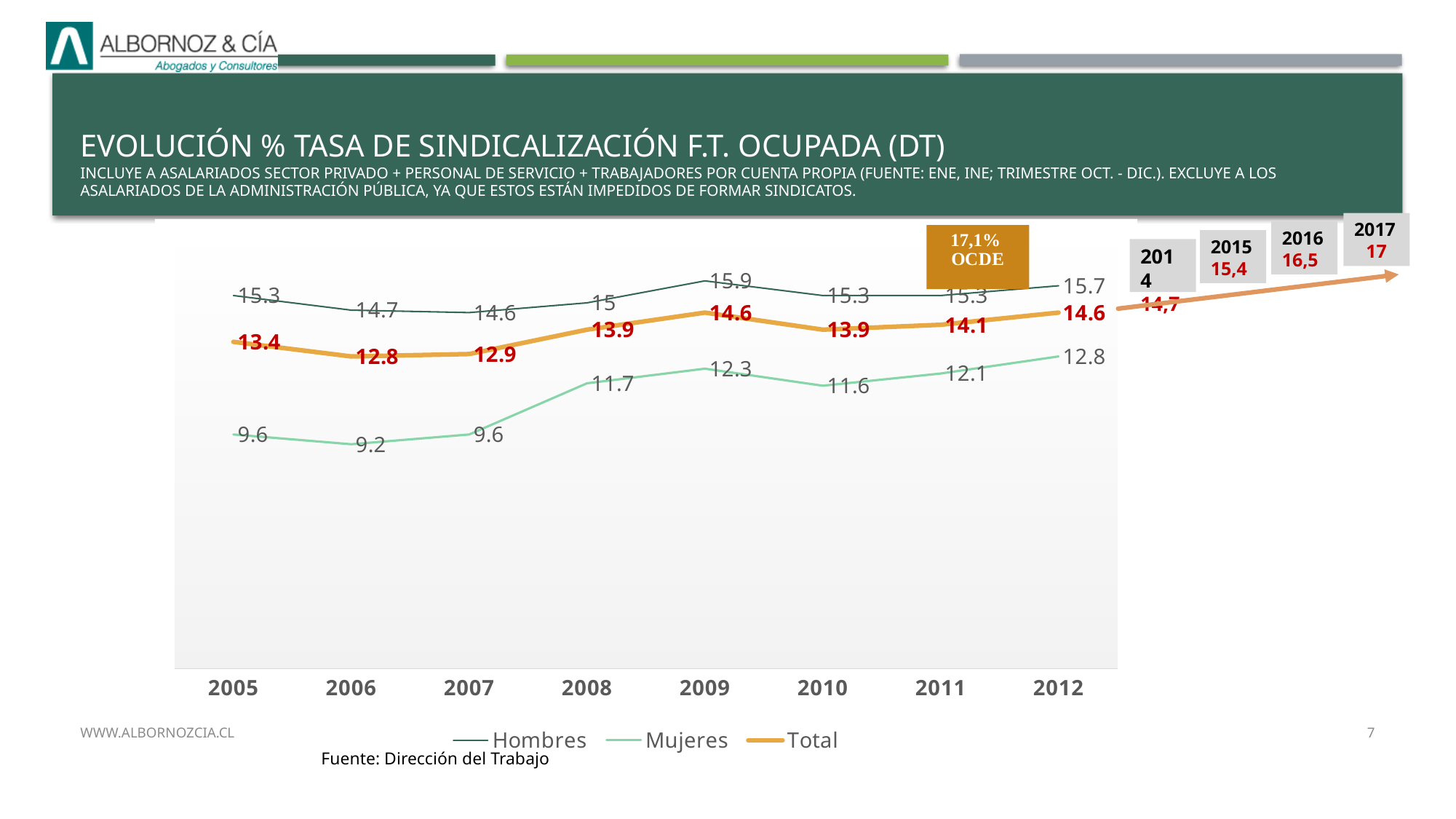
In which year is the Mujeres series at its lowest? 2006 How many years are plotted on the x axis of the chart? 8 Which is larger, the Total value in 2005 or in 2006? 2005 Does the Mujeres series rise or fall overall from 2005 to 2012? Rise How many series does the chart legend list? 3 What is the value for Mujeres in 2008? 11.7 What is the value for Hombres in 2009? 15.9 What kind of chart is shown on the slide? Line chart What is the Total value in 2012? 14.6 Which series is drawn with the thick orange line? Total In which year is the Hombres series at its highest? 2009 What is the difference between the Hombres and Mujeres values in 2012? 2.9